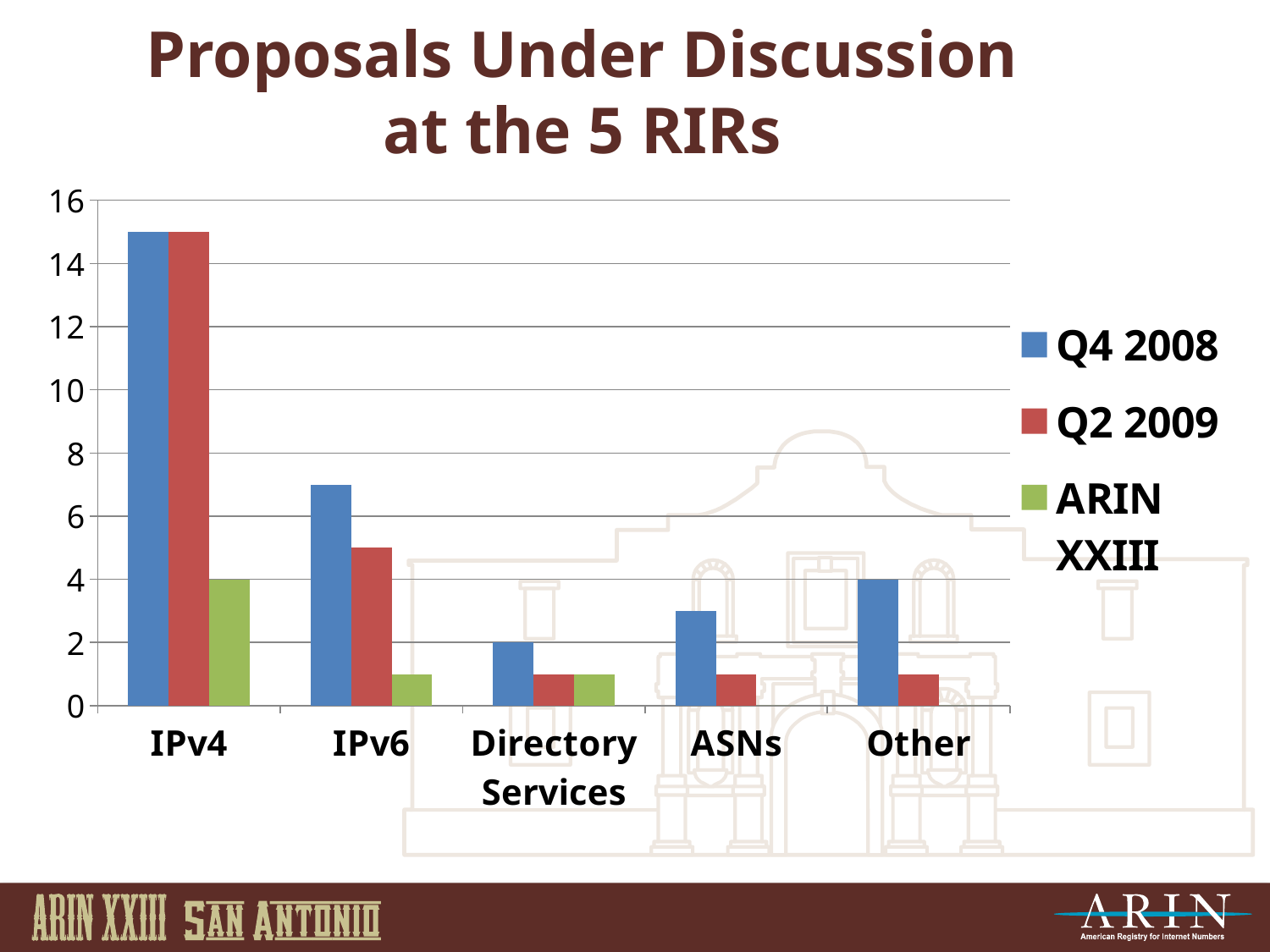
How many categories are shown on the x axis? 5 Is the Q4 2008 value for IPv4 greater or less than 14? greater What kind of chart is shown on the slide? bar chart Which is larger in the IPv6 category, the Q4 2008 value or the Q2 2009 value? Q4 2008 What is the value for ARIN XXIII in the IPv4 category? 4 What is the title of the chart? Proposals Under Discussion at the 5 RIRs How many series does the legend list? 3 Is the Q2 2009 value for IPv6 greater or less than 6? less Which category has the lowest Q4 2008 value? Directory Services What is the value for Q4 2008 in the Directory Services category? 2 What is the value for Q4 2008 in the Other category? 4 Which category has the highest Q4 2008 value? IPv4